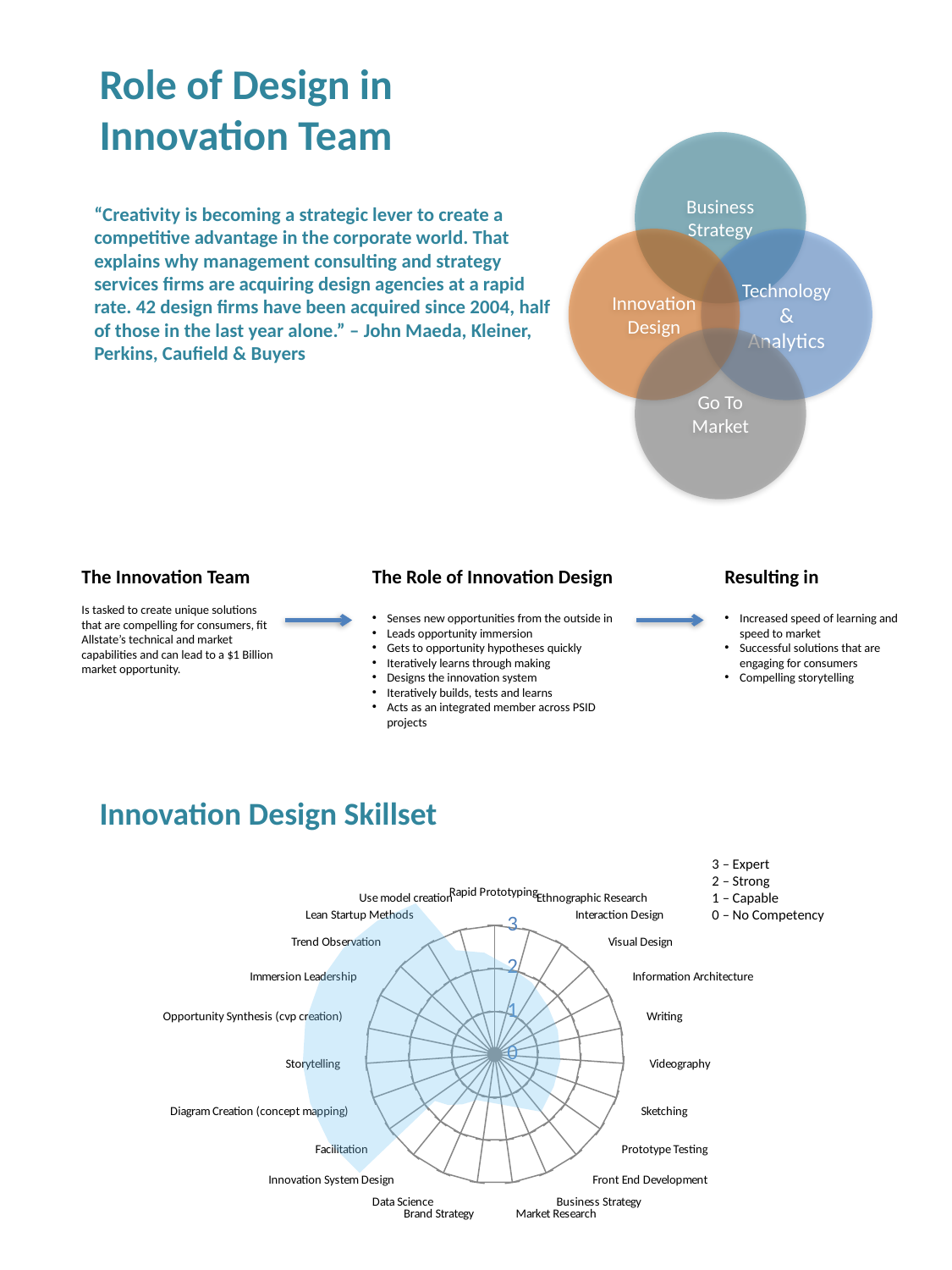
On the Innovation Design Skillset chart, which is larger, the value for Business Strategy or the value for Trend Observation? Trend Observation On the Innovation Design Skillset chart, is the value for Front End Development greater or less than 2? less On the Innovation Design Skillset chart, which is larger, the value for Immersion Leadership or the value for Brand Strategy? Immersion Leadership How many skill categories are plotted on the Innovation Design Skillset radar chart? 23 On the Innovation Design Skillset chart, is the value for Facilitation greater or less than 2? greater On the Innovation Design Skillset chart, what is the highest value shown on the scale? 3 On the Innovation Design Skillset chart, is the value for Market Research greater or less than 2? less On the Innovation Design Skillset chart, what competency level does a score of 3 represent? Expert What kind of chart is the Innovation Design Skillset chart? radar chart